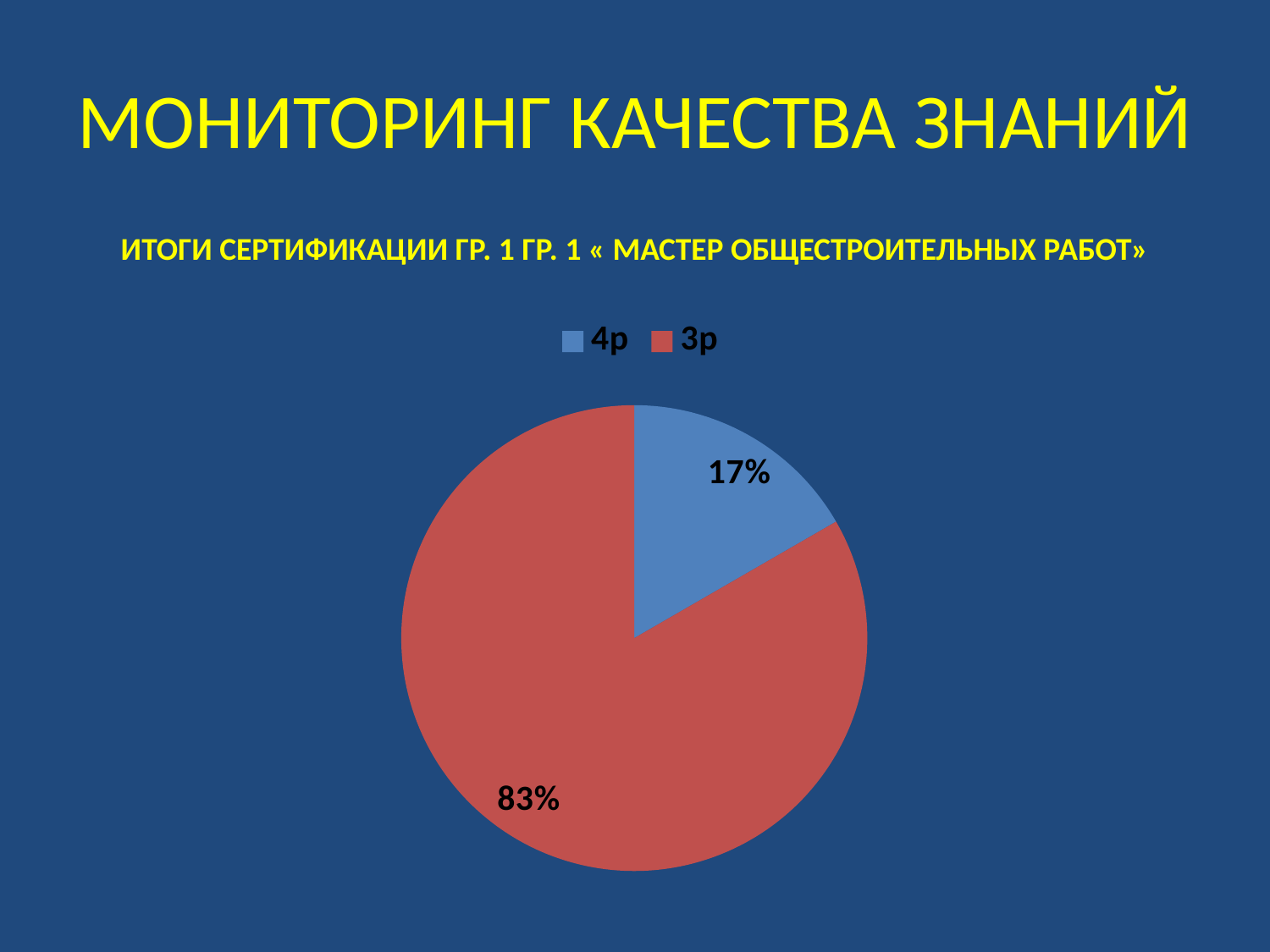
Which category has the largest slice of the pie? 3р What kind of chart is shown on the slide? pie chart How many entries does the legend list? 2 Which category has the smallest slice of the pie? 4р What colour is the 4р slice? blue What colour is the 3р slice? red What share of the pie does the 4р slice represent? 17% Which slice is larger, 4р or 3р? 3р What share of the pie does the 3р slice represent? 83% What is the difference in percentage points between the 3р and 4р slices? 66 How many slices does the pie chart have? 2